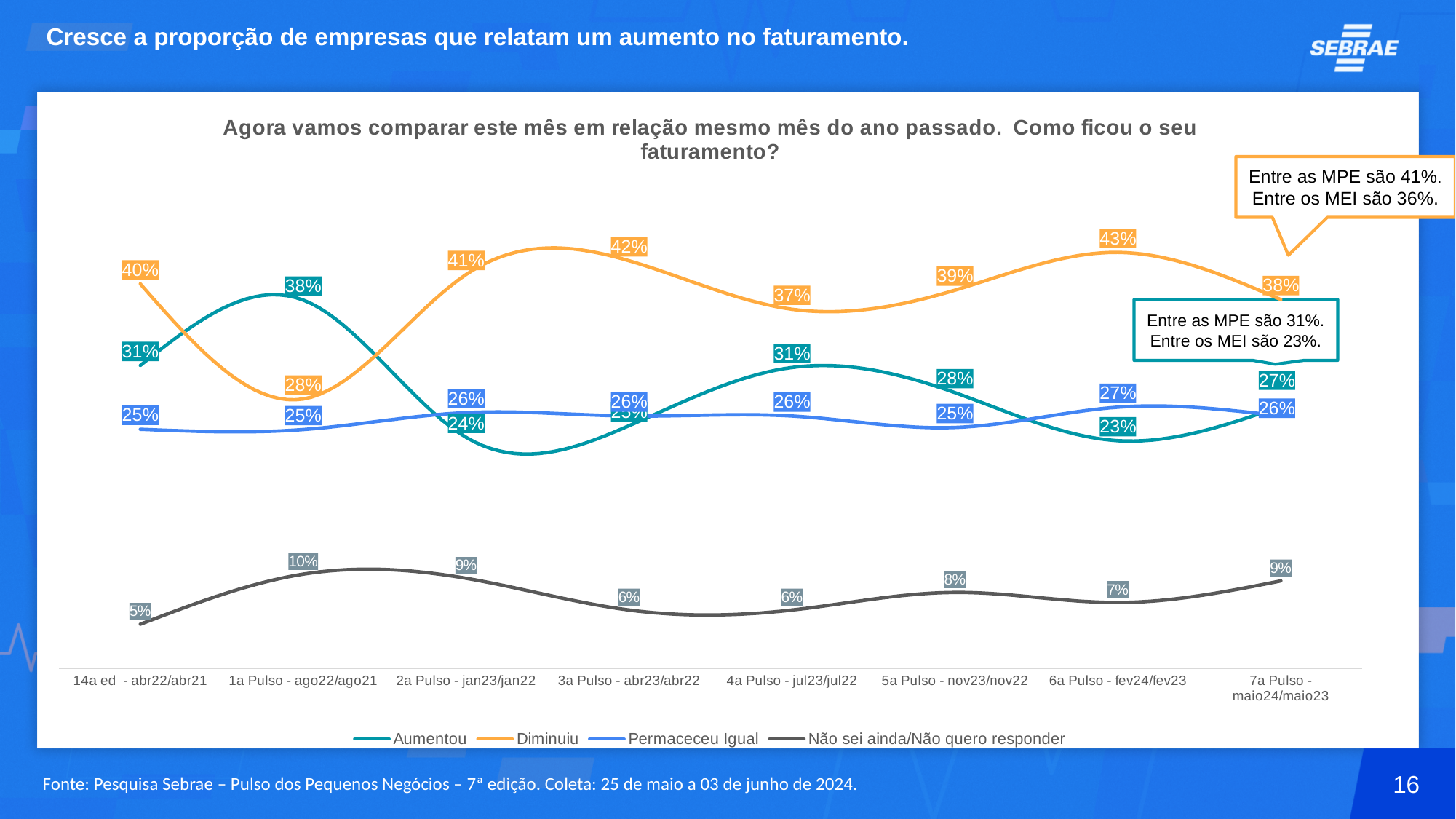
What is the value of Diminuiu for 6a Pulso - fev24/fev23? 43% What is the value of Não sei ainda/Não quero responder for 14a ed - abr22/abr21? 5% What is the difference between Diminuiu and Aumentou for 7a Pulso - maio24/maio23? 11 percentage points What kind of chart is shown on the slide? line chart For 1a Pulso - ago22/ago21, which is larger: Aumentou or Diminuiu? Aumentou In which edition does the Aumentou series reach its lowest value? 6a Pulso - fev24/fev23 What is the value of Aumentou for 7a Pulso - maio24/maio23? 27% In which edition does the Diminuiu series reach its highest value? 6a Pulso - fev24/fev23 What is the value of Permaceceu Igual for 6a Pulso - fev24/fev23? 27% How many series does the legend list? 4 Which series is drawn in orange? Diminuiu How many survey editions (categories) are shown on the x axis? 8